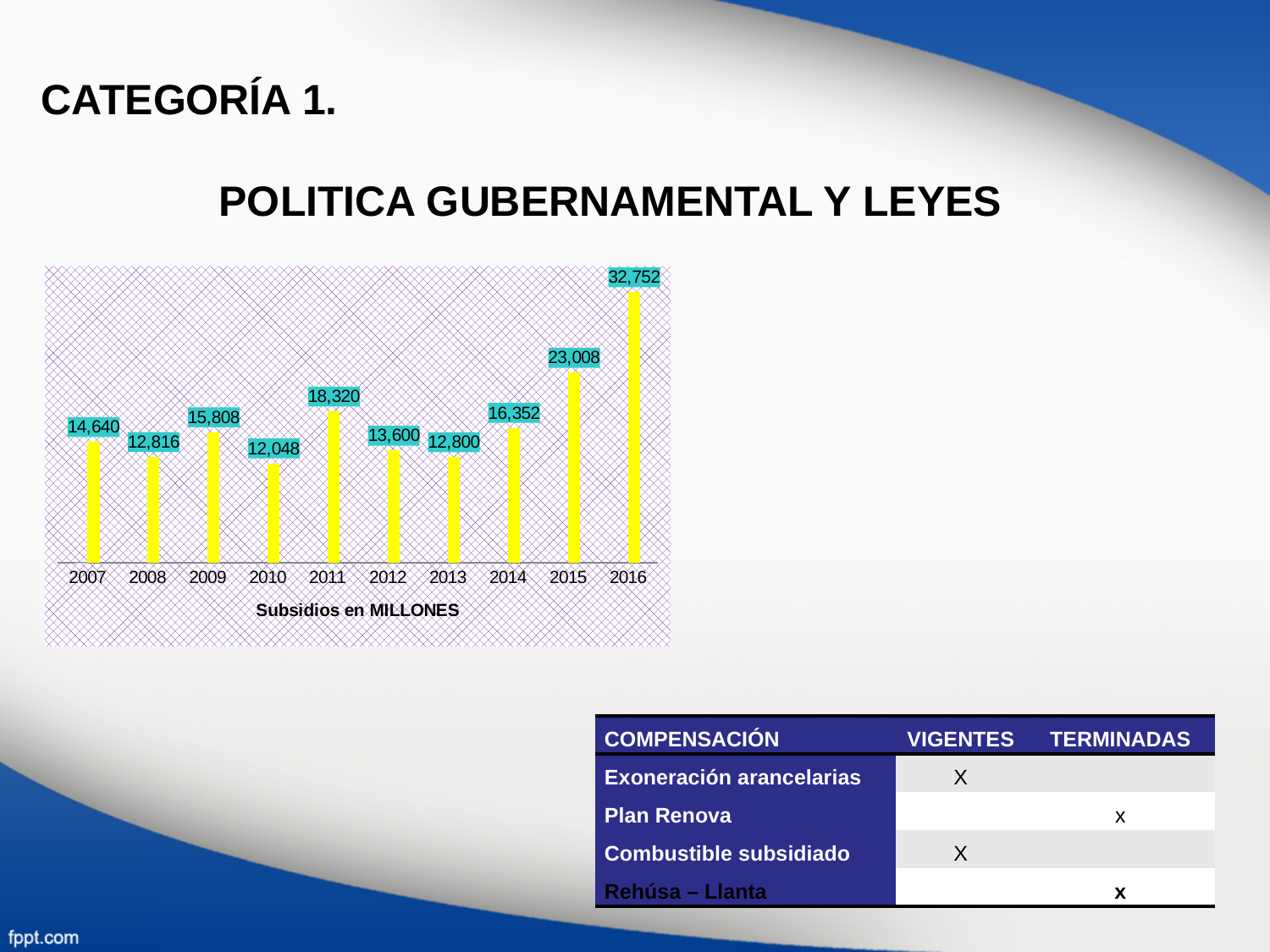
What is the axis title shown below the years in the chart? Subsidios en MILLONES What is the value for 2007 in the chart? 14,640 Which year has the lowest value in the chart? 2010 What is the difference between the values for 2016 and 2015? 9,744 Which year has the highest value in the chart? 2016 What kind of chart is shown on the slide? Bar chart Which is larger, the value for 2007 or the value for 2012? 2007 What is the value for 2016 in the chart? 32,752 Which is larger, the value for 2009 or the value for 2014? 2014 What is the value for 2011 in the chart? 18,320 What is the difference between the values for 2011 and 2010? 6,272 How many years are shown on the x axis of the chart? 10